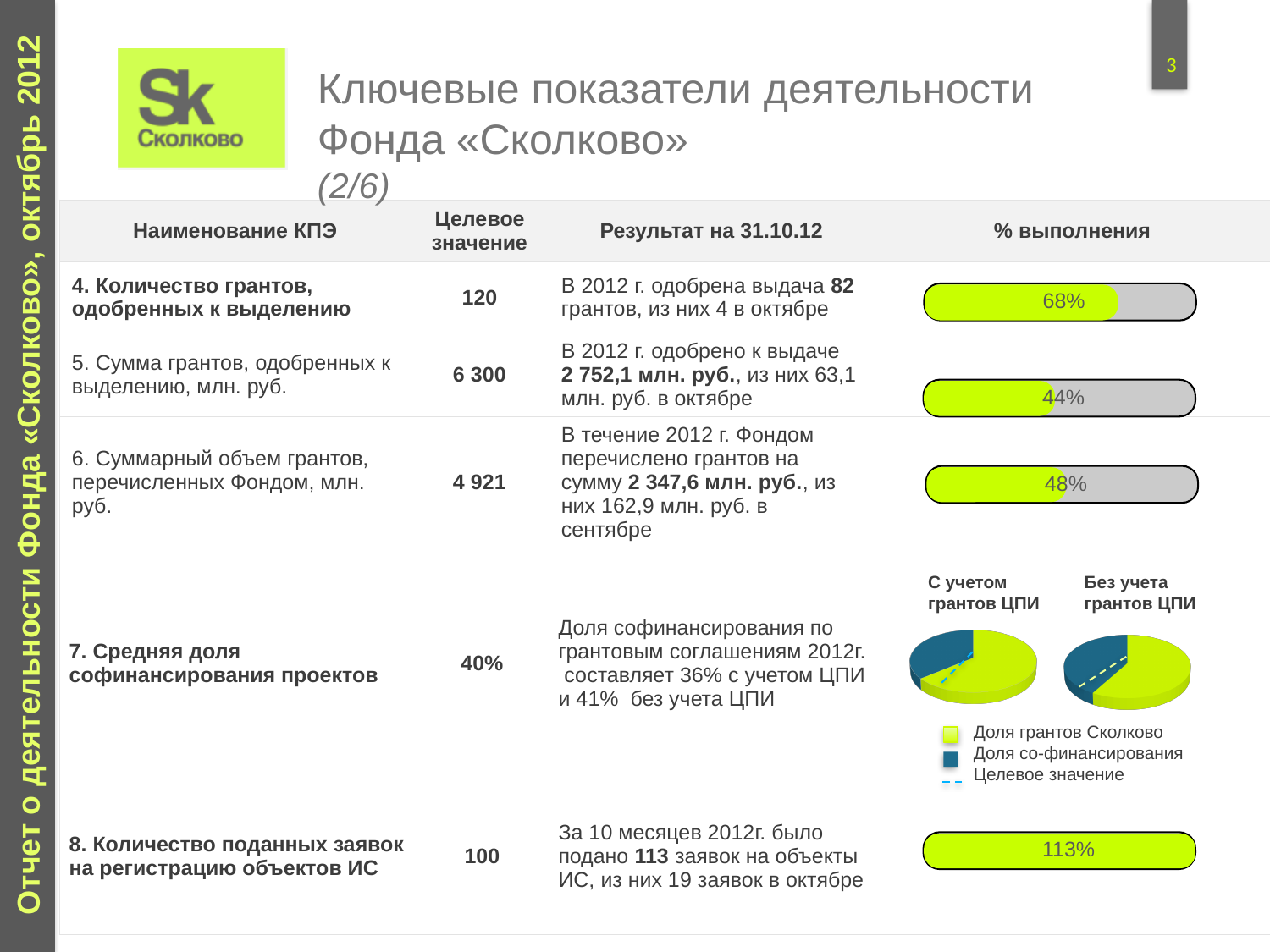
How many entries does the legend of the pie charts for KPI 7 list? 3 Which is larger: the completion percentage for KPI 6 or for KPI 5? KPI 6 (48%) What type of chart is used in the '% выполнения' column for KPI 7 (average share of project co-financing)? Pie chart What percentage of completion is shown for KPI 4 (number of grants approved for allocation)? 68% Which KPI has the highest percentage of completion shown in the progress bars? 8. Количество поданных заявок на регистрацию объектов ИС Is the completion percentage for KPI 8 greater or less than 100%? greater What percentage of completion is shown for KPI 8 (number of applications submitted for registration of IP objects)? 113% How many progress bars showing percentage of completion are on the slide? 4 What percentage of completion is shown for KPI 5 (sum of grants approved for allocation)? 44% What percentage of completion is shown for KPI 6 (total volume of grants transferred by the Fund)? 48% Which KPI has the lowest percentage of completion shown in the progress bars? 5. Сумма грантов, одобренных к выделению, млн. руб. What is the difference in percentage points between the completion of KPI 4 (68%) and KPI 5 (44%)? 24